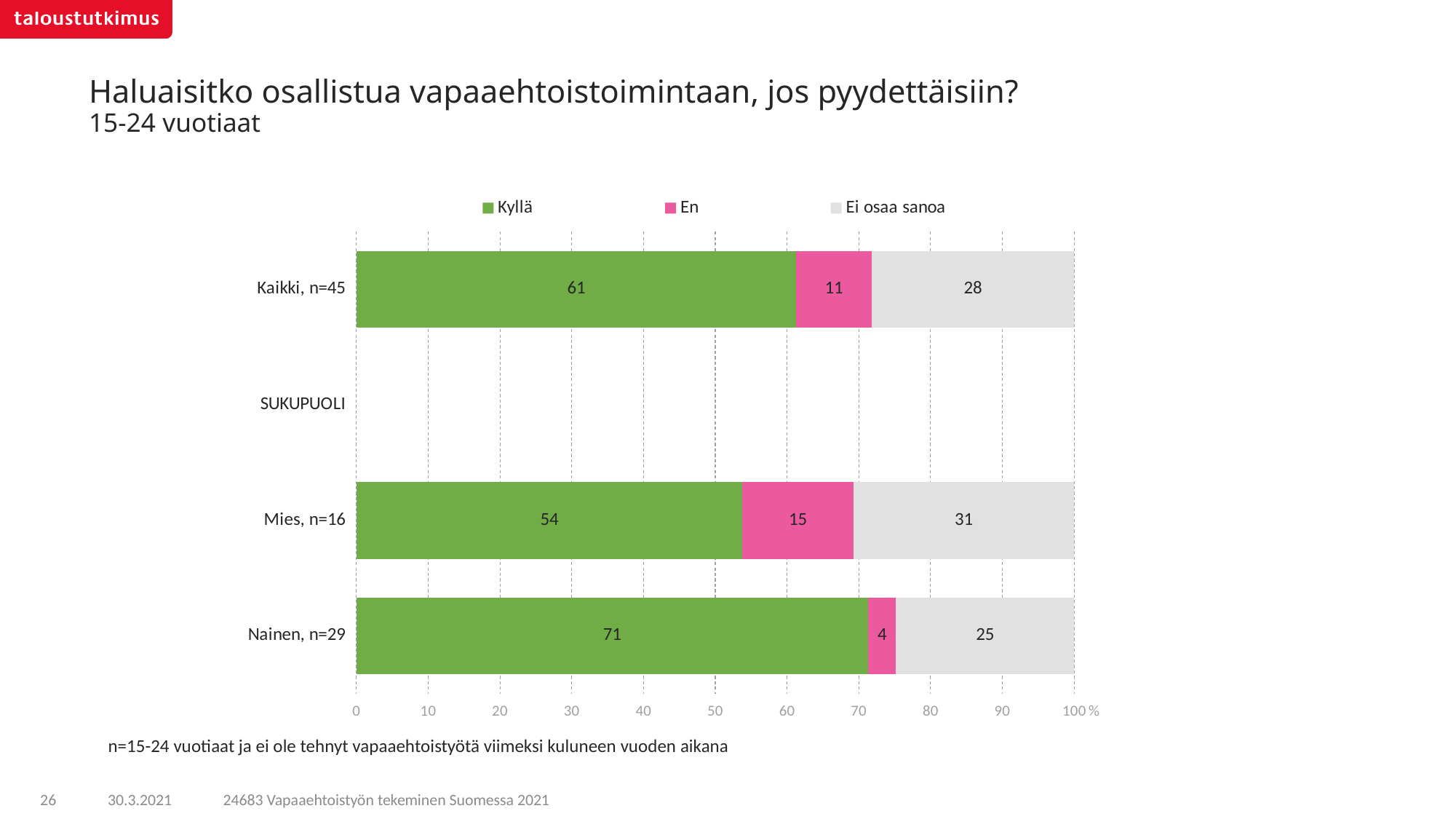
Which group has the highest Kyllä value? Nainen, n=29 What is the Kyllä value for Kaikki, n=45? 61 How many series does the legend list? 3 What is the total of the stacked bar for Mies, n=16? 100 Which is larger, the Ei osaa sanoa value for Mies, n=16 or for Kaikki, n=45? Mies, n=16 Which colour represents the En series in the chart? Pink What kind of chart is shown on the slide? Stacked bar chart What is the difference between the Kyllä values for Nainen, n=29 and Mies, n=16? 17 What is the En value for Mies, n=16? 15 How many groups have data bars plotted in the chart? 3 Which group has the lowest En value? Nainen, n=29 What is the Ei osaa sanoa value for Nainen, n=29? 25